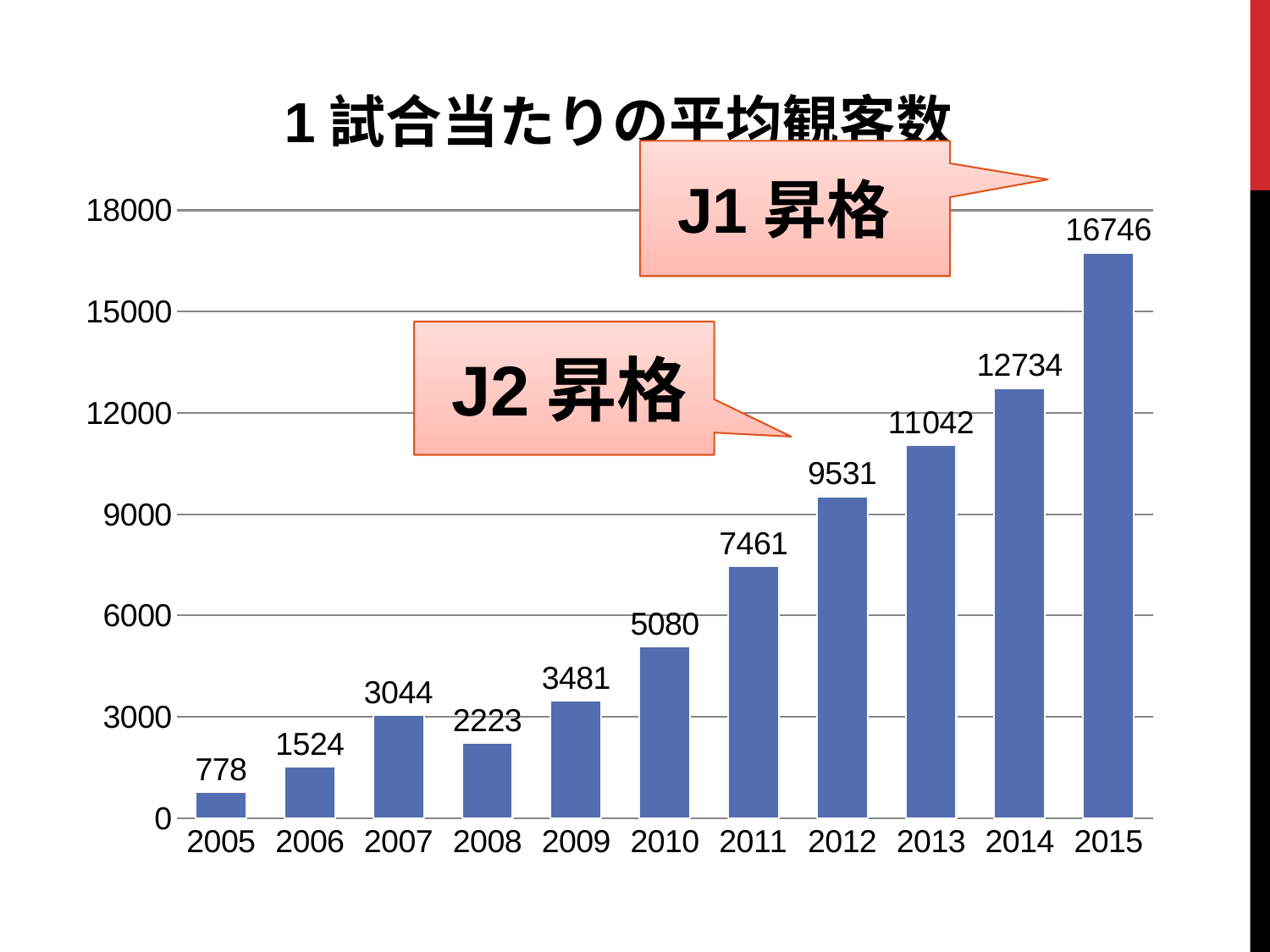
What is the title of the chart? １試合当たりの平均観客数 What kind of chart is shown on the slide? bar chart What is the difference between the values for 2015 and 2014? 4012 Which year has the highest value? 2015 Which year has the lowest value? 2005 What is the value for 2010? 5080 How many years are shown on the x axis? 11 Is the value for 2012 greater or less than 9000? greater What is the value for 2005? 778 What is the difference between the values for 2008 and 2007? 821 What is the value for 2013? 11042 Which is larger, the value for 2007 or the value for 2008? 2007